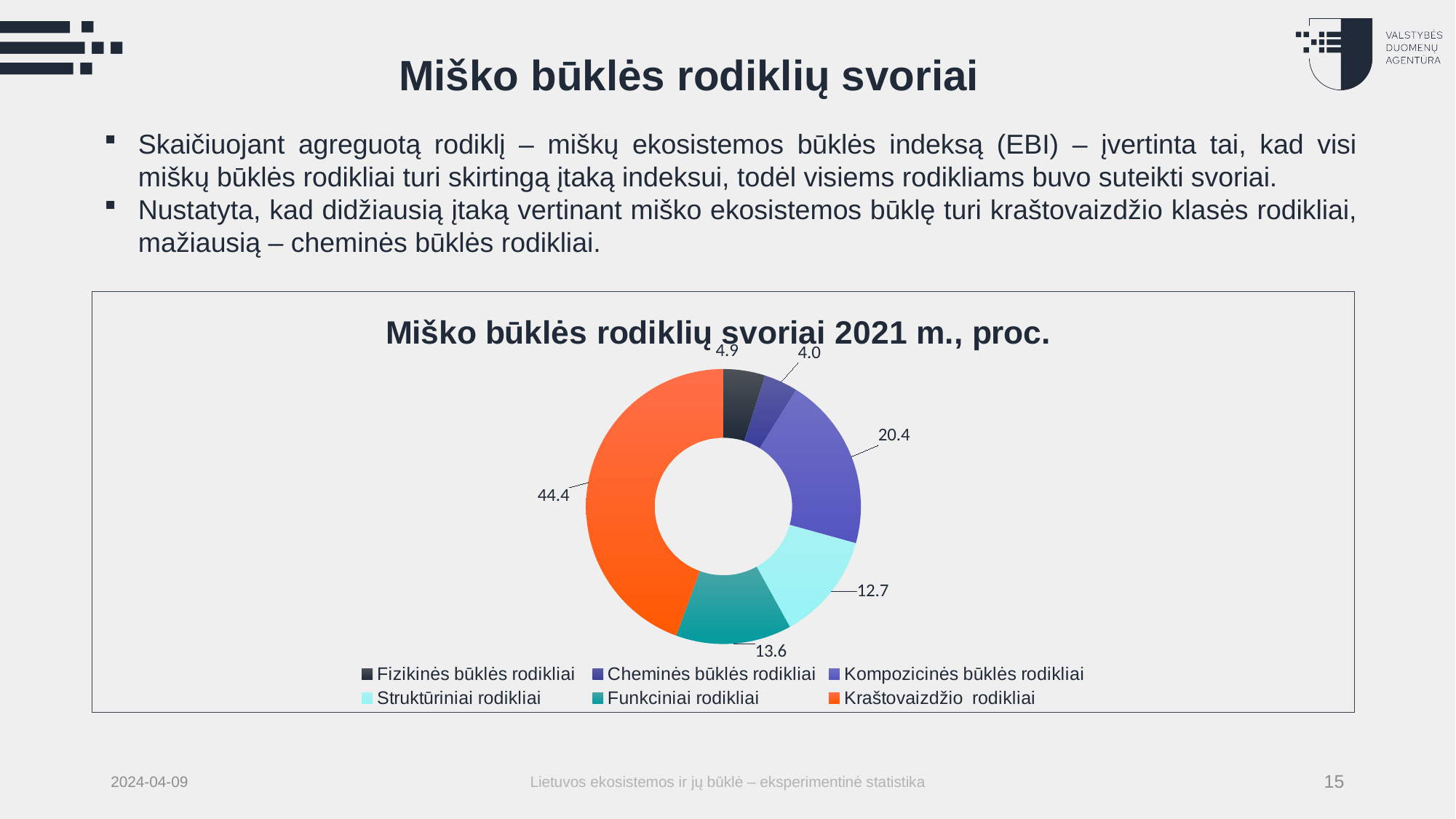
What type of chart is shown on the slide? Doughnut (pie) chart What is the difference between the values for Kraštovaizdžio rodikliai and Kompozicinės būklės rodikliai? 24.0 Which category has the smallest share of the chart? Cheminės būklės rodikliai What colour is the slice for Kraštovaizdžio rodikliai? Orange Which category has the largest share of the chart? Kraštovaizdžio rodikliai What is the value for Funkciniai rodikliai? 13.6 Which is larger, the value for Funkciniai rodikliai or Struktūriniai rodikliai? Funkciniai rodikliai What is the chart's title? Miško būklės rodiklių svoriai 2021 m., proc. What is the value for Kompozicinės būklės rodikliai? 20.4 How many categories does the chart show? 6 What is the value for Cheminės būklės rodikliai? 4.0 What is the value for Kraštovaizdžio rodikliai? 44.4